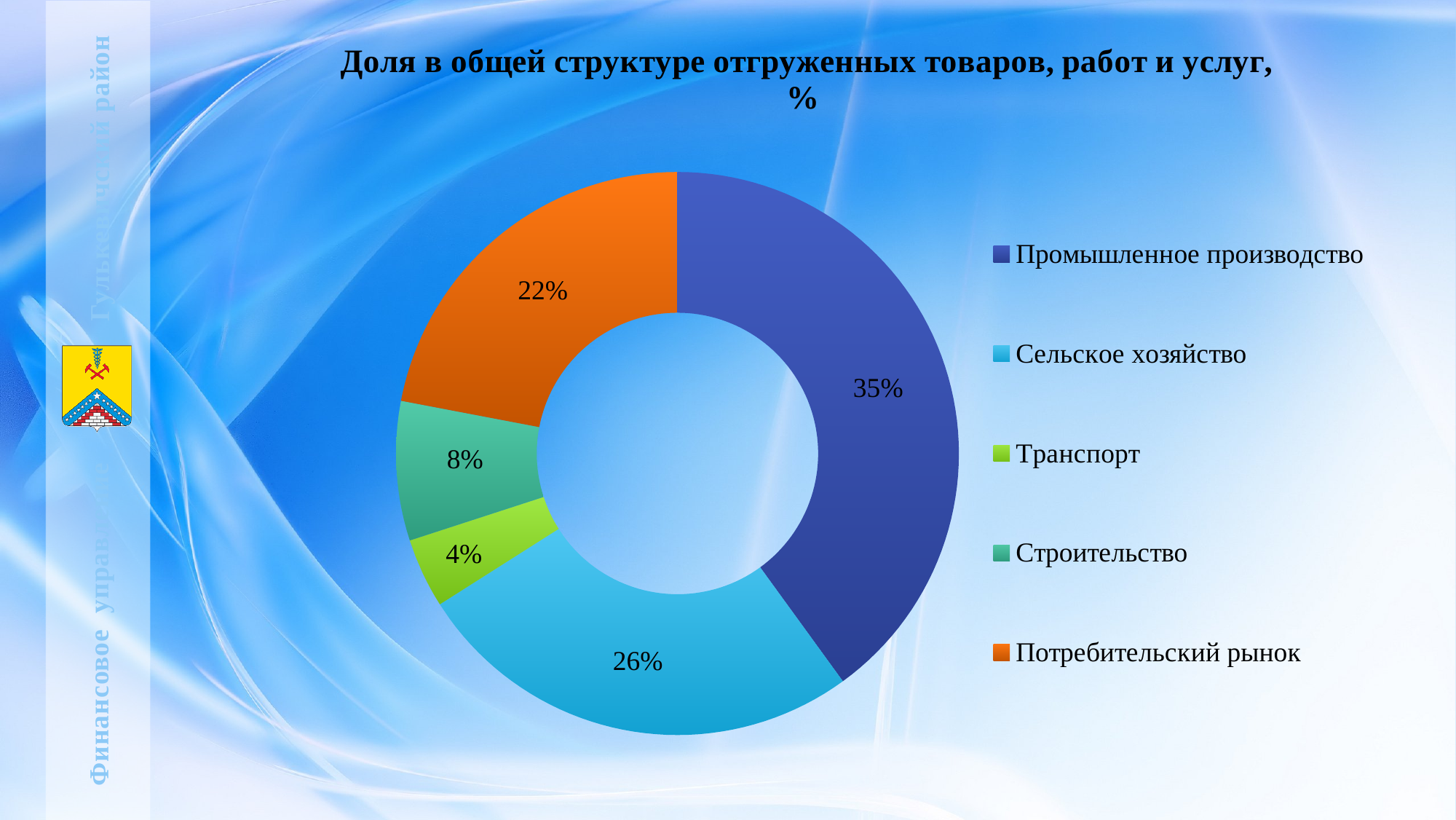
What share does Транспорт have in the chart? 4% What share does Потребительский рынок have in the chart? 22% What is the difference in percentage points between Промышленное производство and Сельское хозяйство? 9 What is the title of the chart? Доля в общей структуре отгруженных товаров, работ и услуг, % What share does Строительство have in the chart? 8% Which has a larger share, Строительство or Потребительский рынок? Потребительский рынок What share does Промышленное производство have in the chart? 35% What share does Сельское хозяйство have in the chart? 26% Which category has the largest share in the chart? Промышленное производство Which category has the smallest share in the chart? Транспорт How many categories are shown in the chart? 5 What kind of chart is shown on the slide? doughnut chart